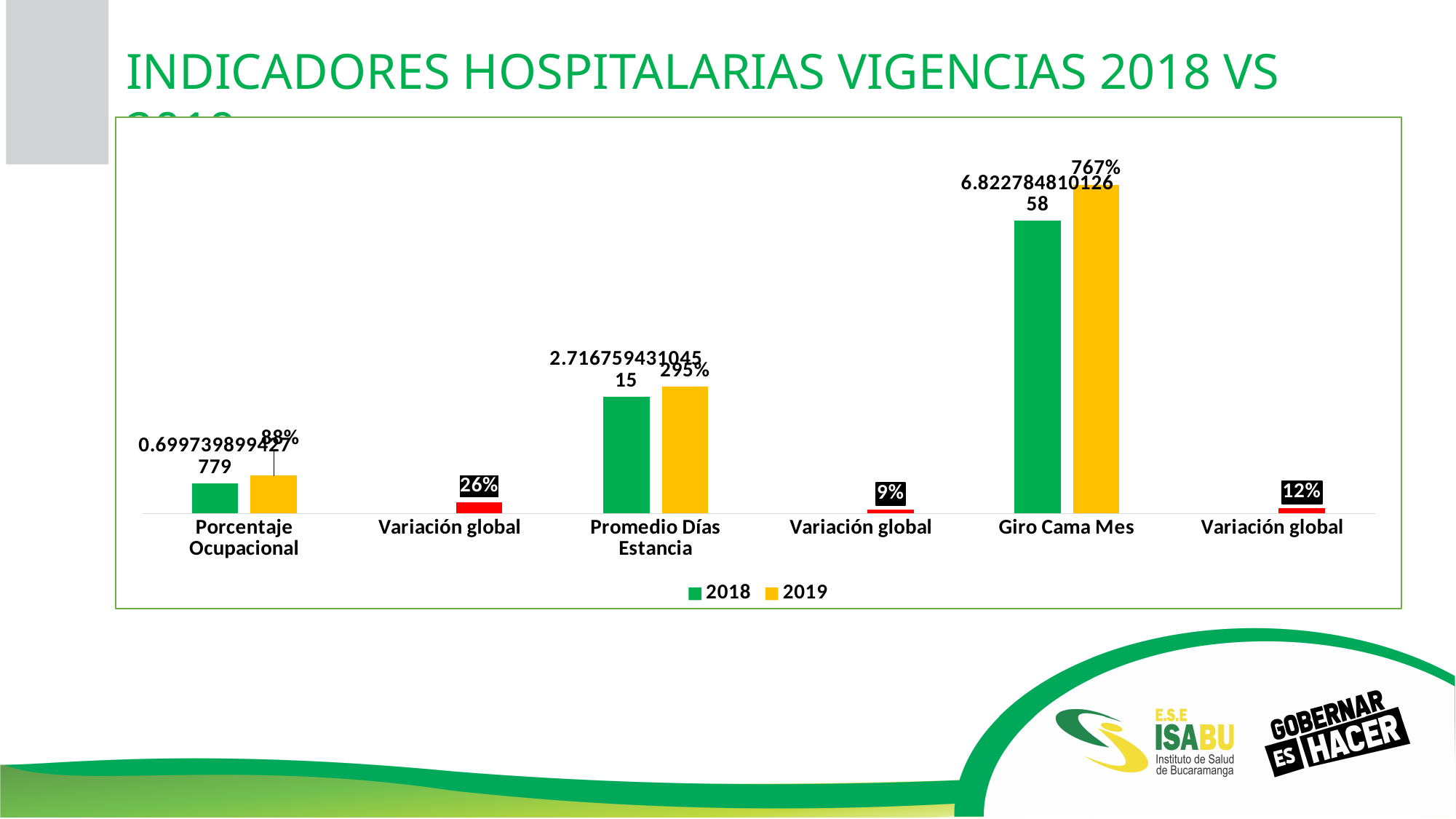
What is the 2019 value for Porcentaje Ocupacional? 88% How many series does the legend list? 2 What is the Variación global value shown after Promedio Días Estancia? 9% What kind of chart is shown on the slide? Bar chart What is the Variación global value shown after Giro Cama Mes? 12% Which of the three Variación global values is the lowest? 9% (after Promedio Días Estancia) What is the 2019 value for Promedio Días Estancia? 295% What is the difference between the highest and lowest Variación global values (26% and 9%)? 17% Which colour represents the 2019 series in the legend? Yellow What is the 2019 value for Giro Cama Mes? 767% What is the Variación global value shown after Porcentaje Ocupacional? 26% For Giro Cama Mes, which bar is taller, 2018 or 2019? 2019